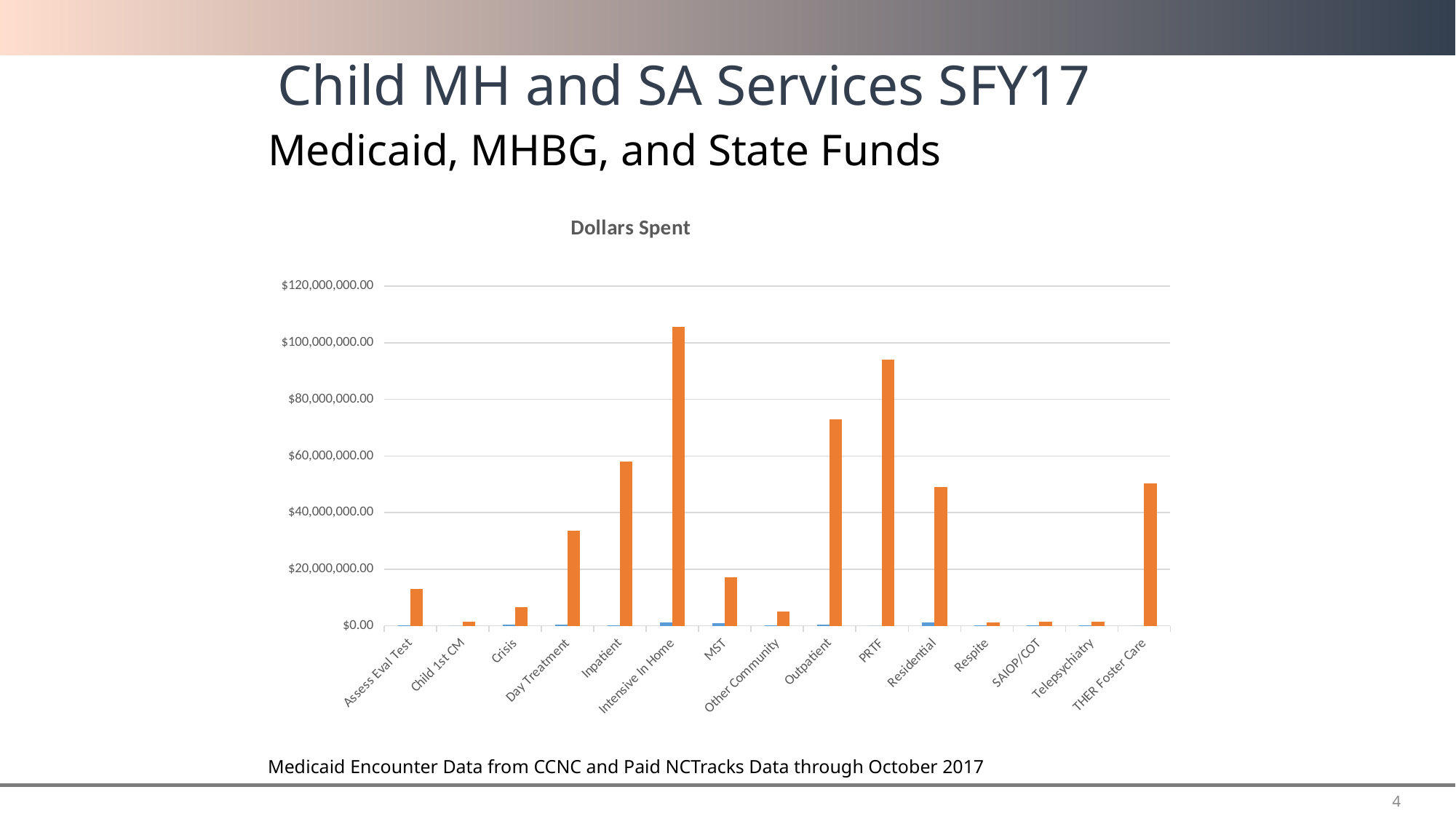
Is the value for THER Foster Care greater or less than $40,000,000.00? greater Which service category has the highest dollars spent? Intensive In Home Which has higher dollars spent, Day Treatment or MST? Day Treatment How many service categories are shown on the x axis of the chart? 15 Is the value for MST greater or less than $20,000,000.00? less Is the value for Outpatient greater or less than $60,000,000.00? greater Which has higher dollars spent, PRTF or Outpatient? PRTF What is the title of the chart? Dollars Spent What kind of chart is shown on the slide? bar chart